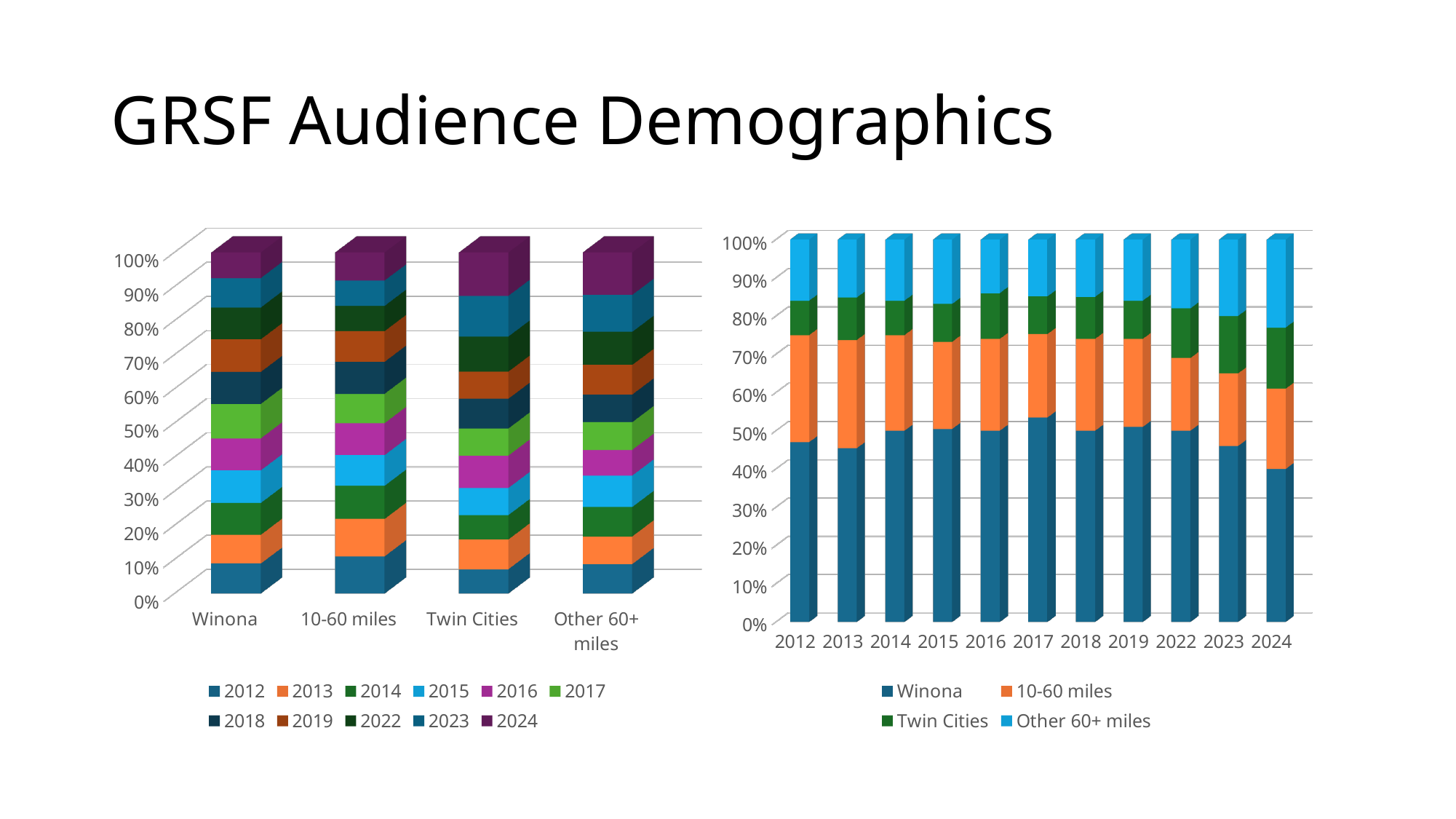
In the right chart, is the Winona share for 2013 greater or less than 50%? less What kind of chart is the chart on the left side of the slide? stacked bar chart In the right chart, is the Winona share for 2024 greater or less than 50%? less In the right chart, which year has the smallest Winona share? 2024 How many categories are shown on the x axis of the left chart? 4 Which series is listed last in the legend of the right chart? Other 60+ miles How many series does the legend of the right chart list? 4 How many years are shown on the x axis of the right chart? 11 What kind of chart is the chart on the right side of the slide? stacked bar chart In the right chart, is the Winona share for 2017 greater or less than 50%? greater What is the title of the slide? GRSF Audience Demographics How many series does the legend of the left chart list? 11